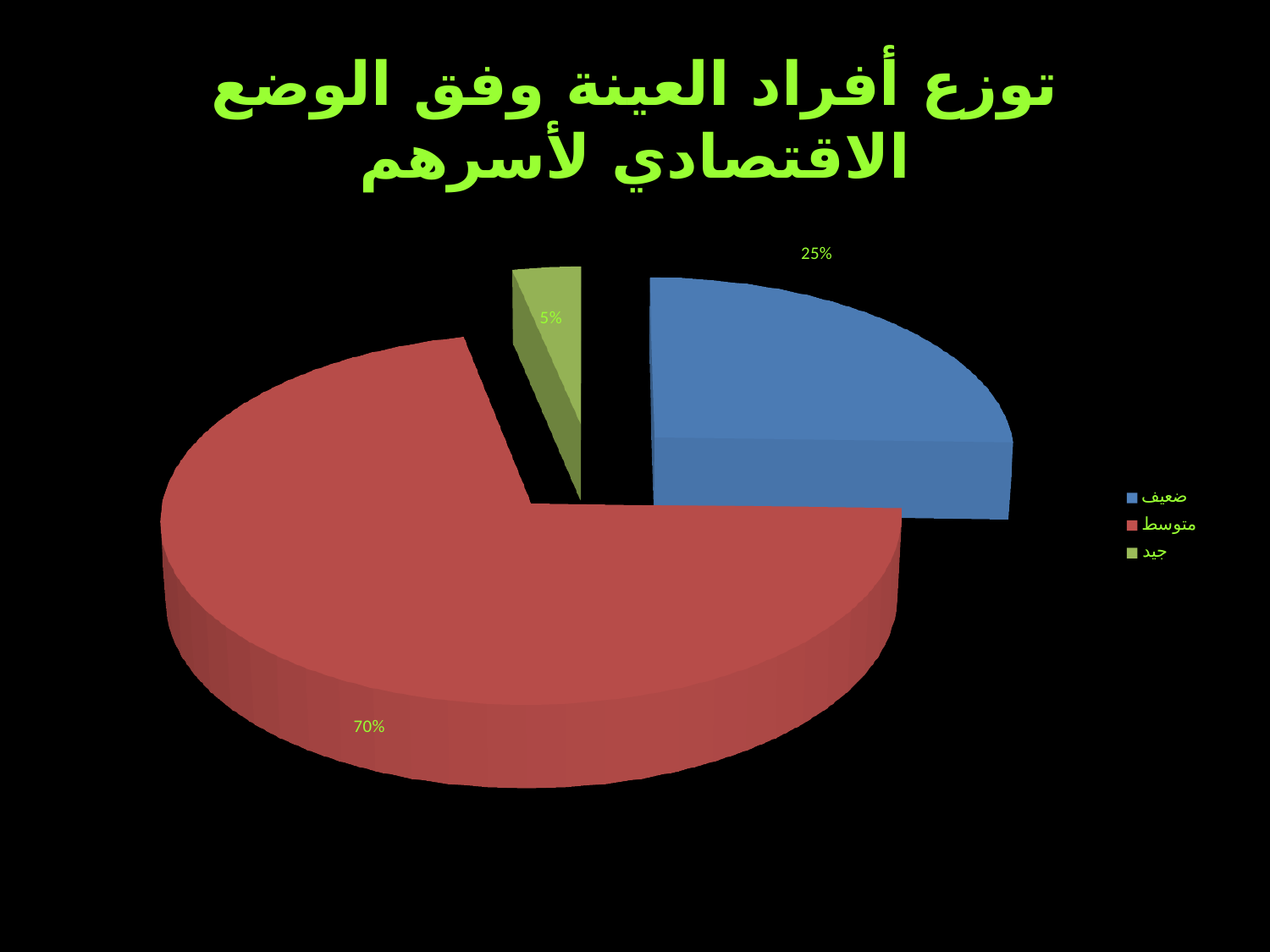
What share of the pie does the جيد slice represent? 5% What is the difference in percentage points between the ضعيف slice and the جيد slice? 20 How many entries does the legend list? 3 Which category has the largest slice of the pie? متوسط What share of the pie does the متوسط slice represent? 70% Which category has the smallest slice of the pie? جيد How many slices does the pie chart have? 3 What colour is the متوسط slice? red What share of the pie does the ضعيف slice represent? 25% What kind of chart is shown on the slide? pie chart Which slice is larger, ضعيف or جيد? ضعيف What is the difference in percentage points between the متوسط slice and the ضعيف slice? 45